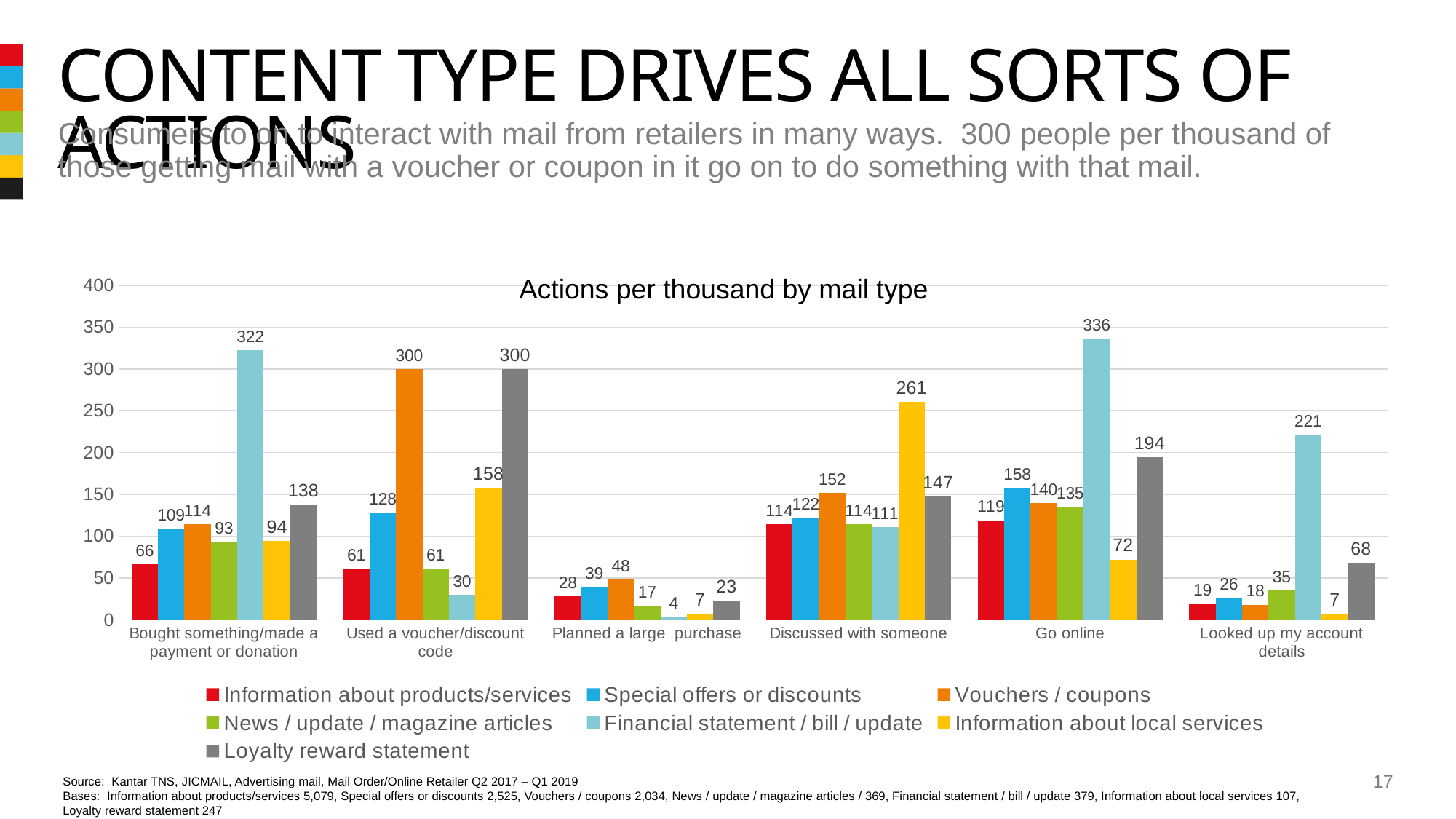
How many action categories are shown on the x axis? 6 What is the difference between the Financial statement / bill / update value and the Loyalty reward statement value under Go online? 142 What is the title of the chart? Actions per thousand by mail type What is the value for Financial statement / bill / update under Go online? 336 What is the value for Loyalty reward statement under Looked up my account details? 68 Under Used a voucher/discount code, which is larger: Special offers or discounts or Information about local services? Information about local services Which mail type has the lowest value under Planned a large purchase? Financial statement / bill / update What is the value for Information about local services under Discussed with someone? 261 What kind of chart is shown on the slide? Bar chart Which mail type has the highest value under Bought something/made a payment or donation? Financial statement / bill / update How many series does the legend list? 7 What is the value for Vouchers / coupons under Used a voucher/discount code? 300